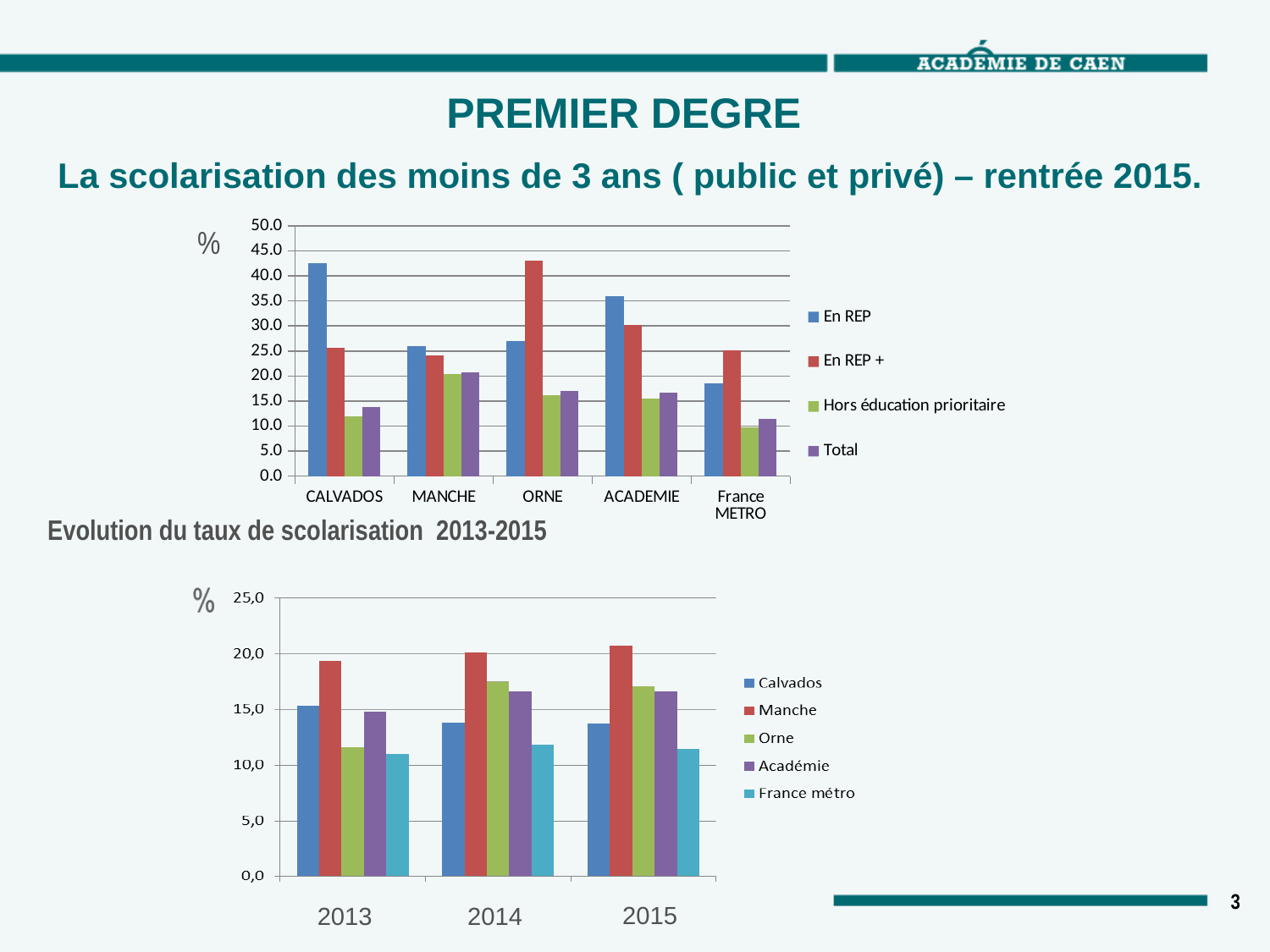
How many series does the legend of the top chart list? 4 In the top chart, is the 'En REP' value for CALVADOS greater or less than 40? greater In the top chart, for ORNE, which is larger: 'En REP' or 'En REP +'? En REP + In the bottom chart, which series has the highest value in 2015? Manche How many categories are shown on the x axis of the top chart? 5 In the top chart, which category has the lowest 'Hors éducation prioritaire' value? France METRO What kind of chart is the top chart on the slide? bar chart In the top chart, is the 'Total' value for France METRO greater or less than 15? less In the bottom chart, does the value for Manche rise or fall from 2013 to 2015? rises In the bottom chart, is the value for Orne in 2013 greater or less than 15,0? less In the top chart, which category has the highest 'En REP +' value? ORNE How many series does the legend of the bottom chart (Evolution du taux de scolarisation 2013-2015) list? 5